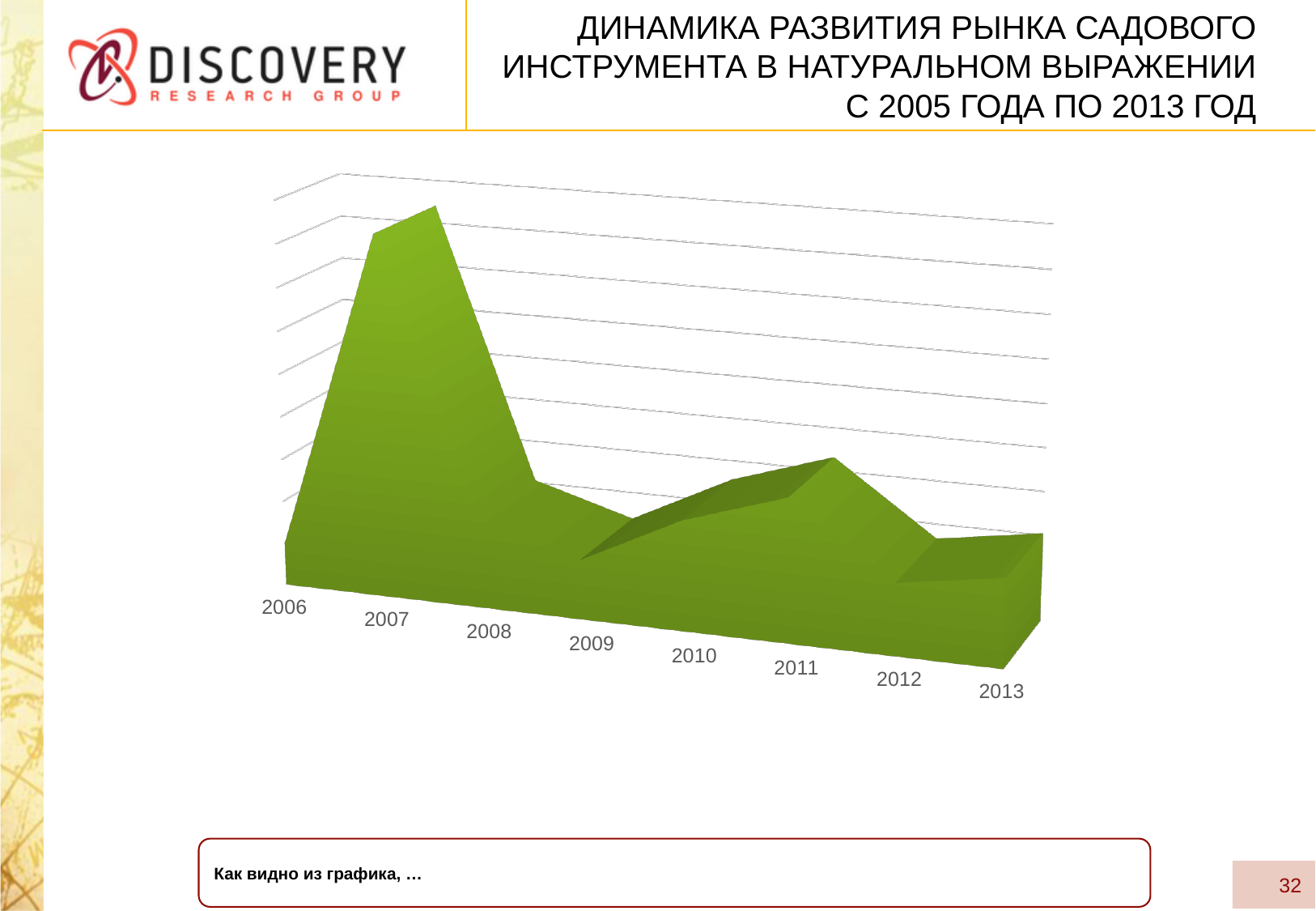
What kind of chart is shown on the slide? area chart Which year has the highest value in the chart? 2007 Which is larger, the value for 2006 or the value for 2007? 2007 Do the values rise or fall from 2009 to 2011? rise Do the values rise or fall from 2007 to 2009? fall Which is larger, the value for 2009 or the value for 2011? 2011 How many years are shown on the x axis of the chart? 8 What is the first year shown on the x axis of the chart? 2006 Which is larger, the value for 2007 or the value for 2008? 2007 Do the values rise or fall from 2006 to 2007? rise What colour is the area in the chart? green